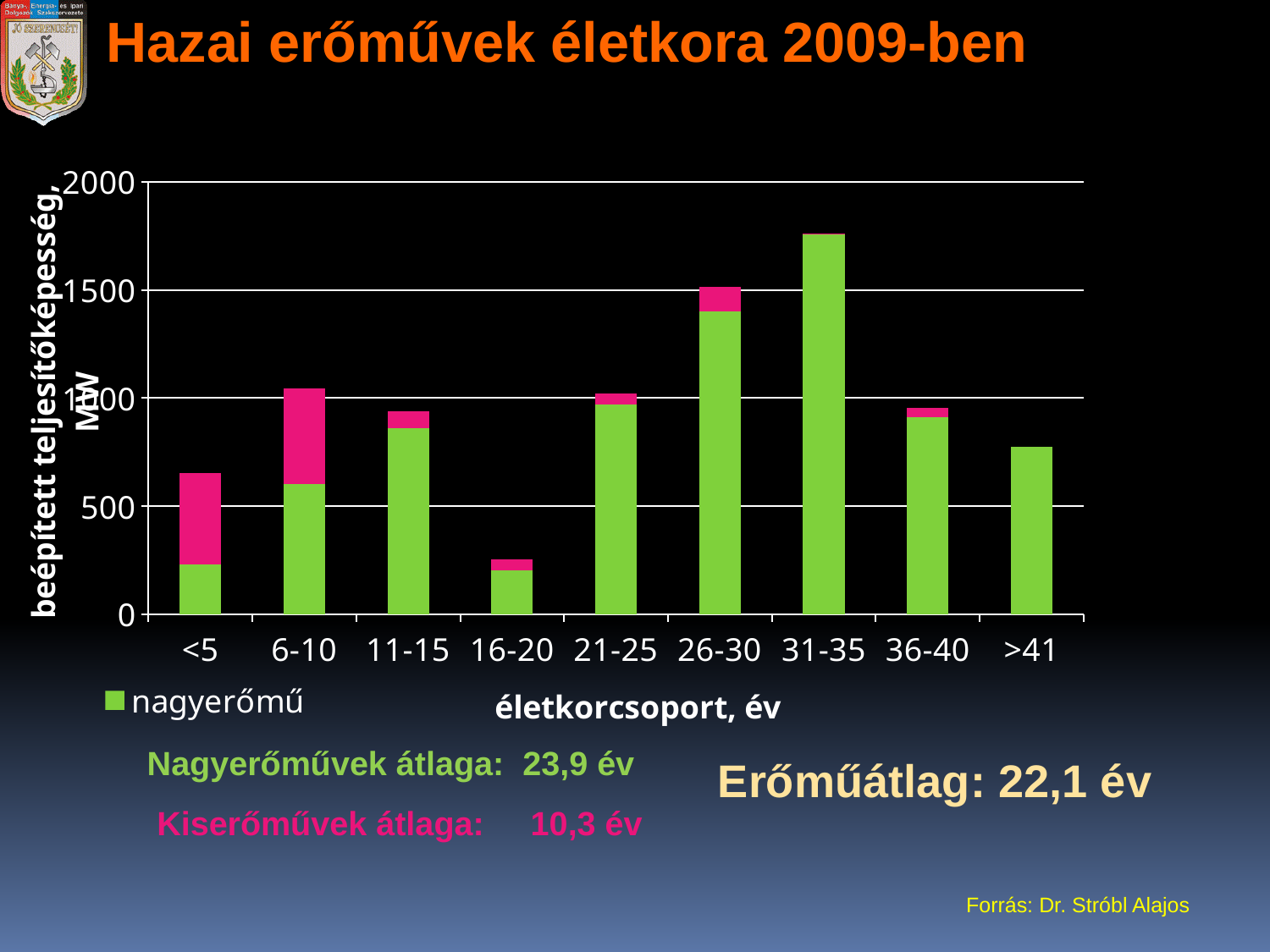
Is the total bar for the <5 age group greater or less than 500? greater Is the total bar for the 16-20 age group greater or less than 500? less What kind of chart is shown on the slide? bar chart Which bar is taller, <5 or 16-20? <5 How many series does the legend list? 1 What is the title of the chart? Hazai erőművek életkora 2009-ben How many age-group categories are shown on the x axis? 9 Which age group has the tallest bar? 31-35 Is the total bar for the >41 age group greater or less than 1000? less Which bar is taller, 31-35 or 26-30? 31-35 Which age group has the shortest bar? 16-20